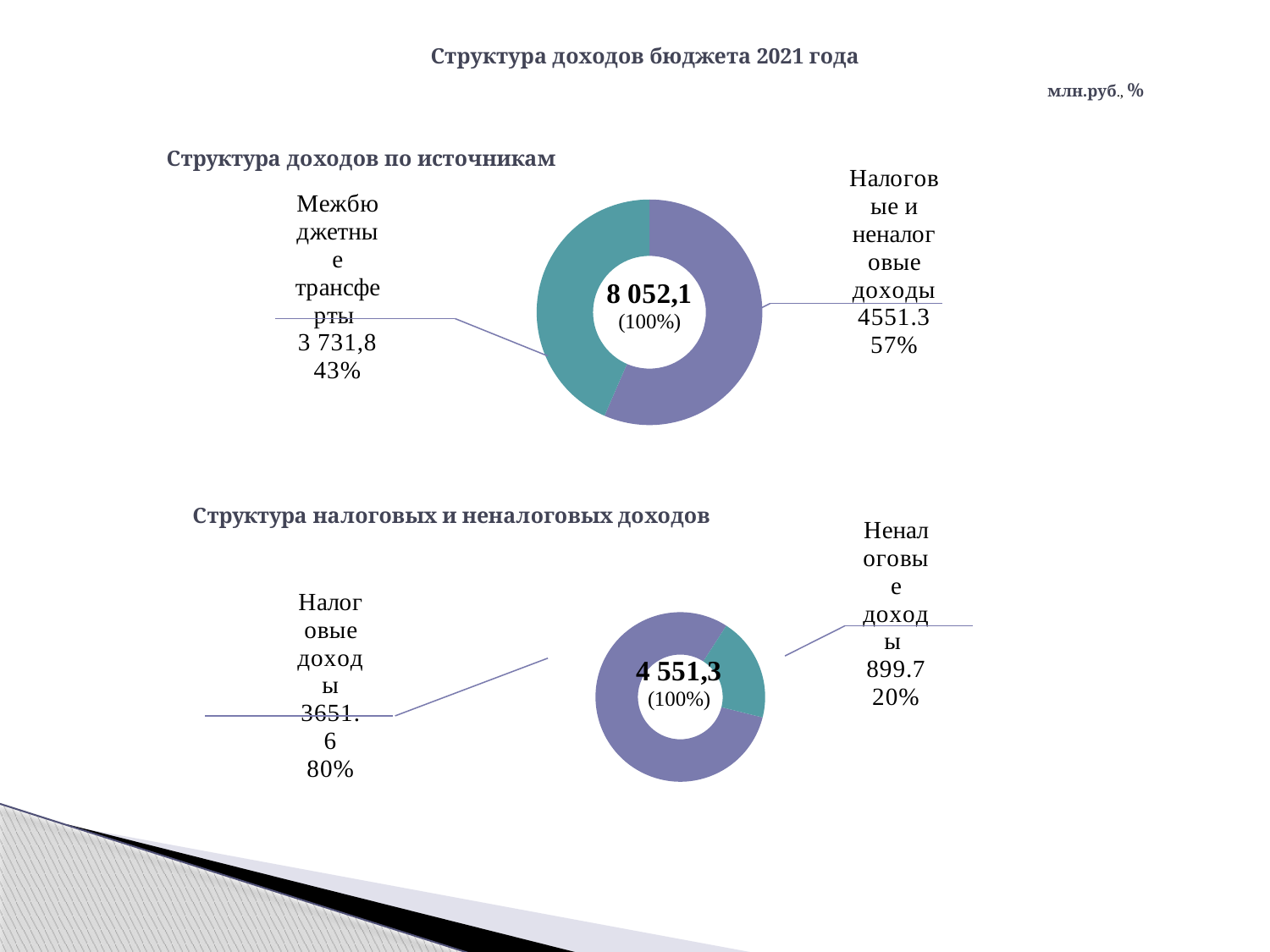
What is the main title of the slide? Структура доходов бюджета 2021 года How many categories does the chart 'Структура налоговых и неналоговых доходов' show? 2 What type of chart is used for 'Структура доходов по источникам'? Doughnut chart In the chart 'Структура доходов по источникам', what total is shown in the centre of the doughnut? 8 052,1 In the chart 'Структура налоговых и неналоговых доходов', what is the value for 'Неналоговые доходы'? 899.7 In the chart 'Структура доходов по источникам', what is the value for 'Межбюджетные трансферты'? 3 731,8 In the chart 'Структура налоговых и неналоговых доходов', which category is the smallest? Неналоговые доходы In the chart 'Структура доходов по источникам', what share of the total do 'Налоговые и неналоговые доходы' make up? 57% In the chart 'Структура доходов по источникам', what is the difference in percentage points between 'Налоговые и неналоговые доходы' and 'Межбюджетные трансферты'? 14 In the chart 'Структура доходов по источникам', which category is the largest? Налоговые и неналоговые доходы In the chart 'Структура налоговых и неналоговых доходов', what total is shown in the centre of the doughnut? 4 551,3 In the chart 'Структура налоговых и неналоговых доходов', what share do 'Налоговые доходы' make up? 80%